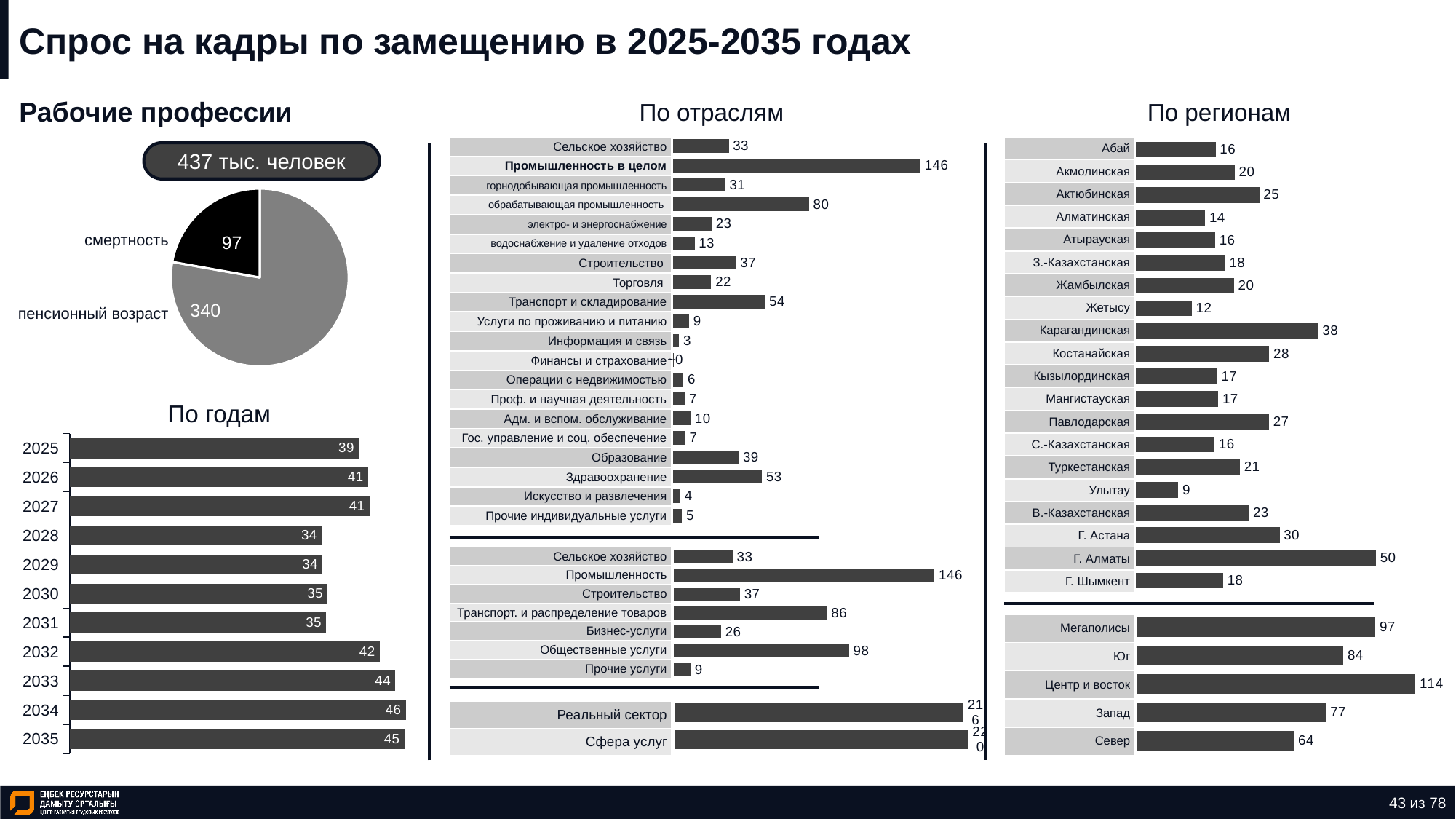
In the "По годам" chart, how many years are plotted? 11 In the "По регионам" chart, which region has the highest value? Г. Алматы In the "По годам" chart, what is the value for 2034? 46 In the pie chart under "Рабочие профессии", what is the value for "смертность"? 97 In the "По отраслям" chart, which is larger: "Строительство" or "Торговля"? Строительство In the pie chart under "Рабочие профессии", what is the value for "пенсионный возраст"? 340 In the "По годам" chart, what is the difference between the values for 2035 and 2025? 6 In the "По отраслям" chart, which category has the highest value? Промышленность в целом In the "По отраслям" chart, what is the value for "Здравоохранение"? 53 In the pie chart under "Рабочие профессии", what is the total shown in the box above the chart? 437 тыс. человек In the "По годам" chart, which year has the highest value? 2034 In the "По регионам" chart, what is the value for "Центр и восток"? 114